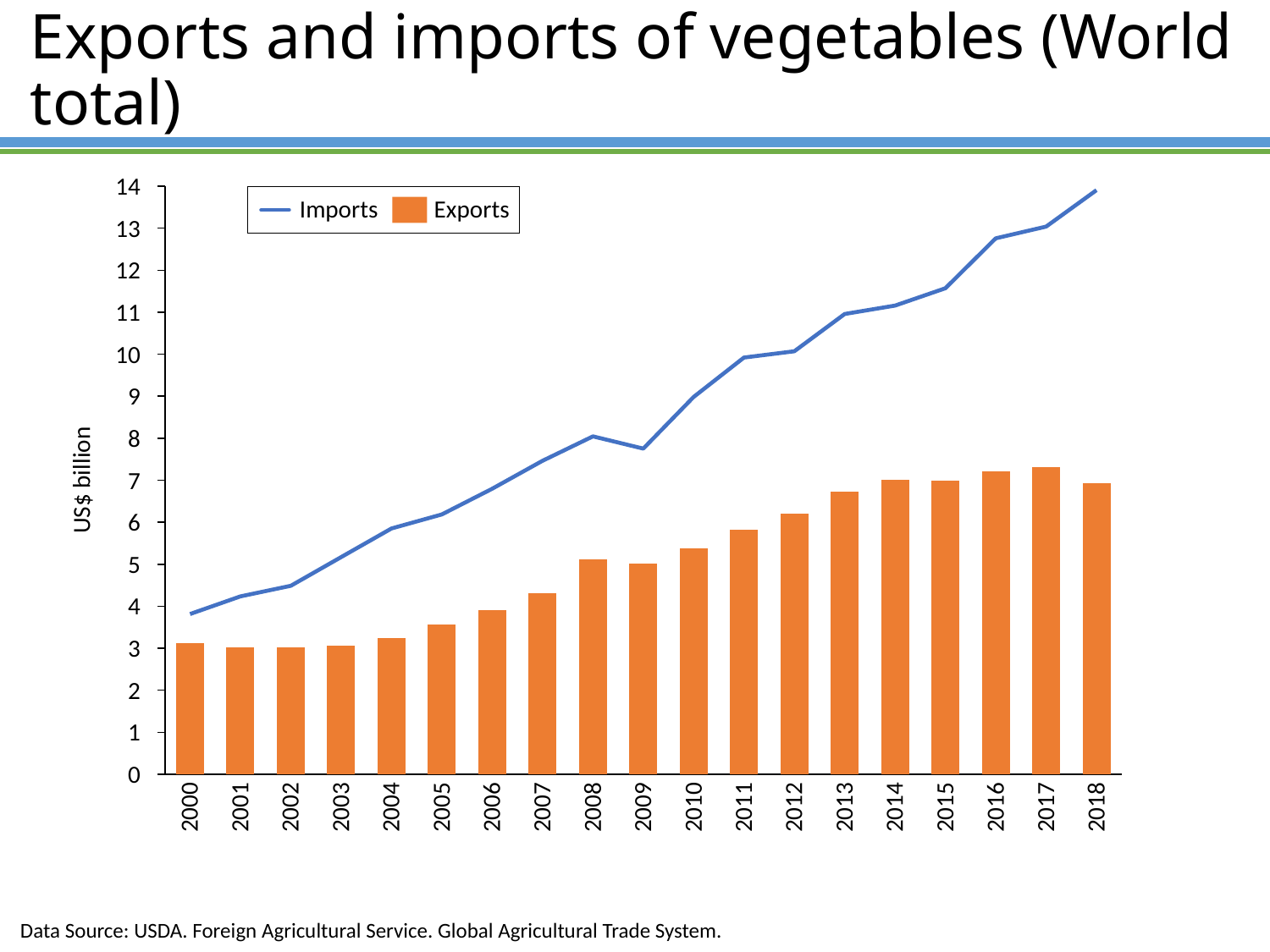
Is the Exports value for 2007 greater or less than 5? less What are the two series named in the legend? Imports and Exports Do the Imports values generally rise or fall from 2000 to 2018? Rise Which is larger, the Exports value for 2013 or for 2007? 2013 Is the Imports value for 2018 greater or less than 13? greater Is the Exports value for 2012 greater or less than 6? greater What kind of chart is this? A combined bar and line chart In 2010, which is larger, Imports or Exports? Imports How many years are shown on the x axis? 19 What is the label on the vertical axis? US$ billion How many series does the legend list? 2